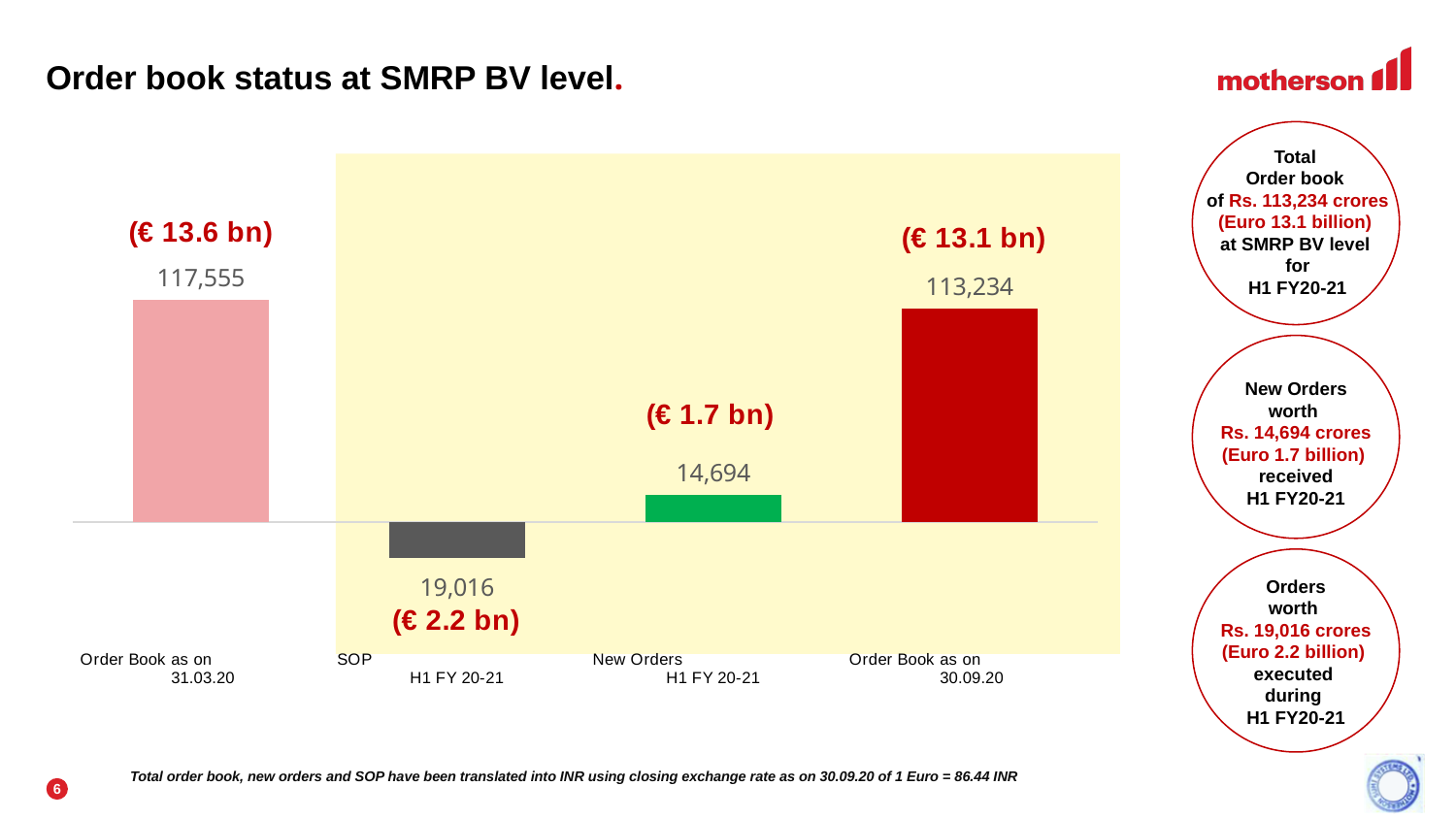
What is the value of the Order Book as on 31.03.20 bar? 117,555 Which category has the lowest value in the chart? SOP H1 FY 20-21 What euro amount is shown above the Order Book as on 31.03.20 bar? (€ 13.6 bn) Which is larger, the SOP H1 FY 20-21 value or the New Orders H1 FY 20-21 value? New Orders H1 FY 20-21 What is the value shown for SOP H1 FY 20-21? 19,016 What type of chart is shown on the slide? Bar chart How many bars are plotted in the chart? 4 What colour is the New Orders H1 FY 20-21 bar? Green What is the difference between the Order Book as on 31.03.20 and the Order Book as on 30.09.20? 4,321 What is the value of the Order Book as on 30.09.20 bar? 113,234 What is the value shown for New Orders H1 FY 20-21? 14,694 Which category has the highest value in the chart? Order Book as on 31.03.20